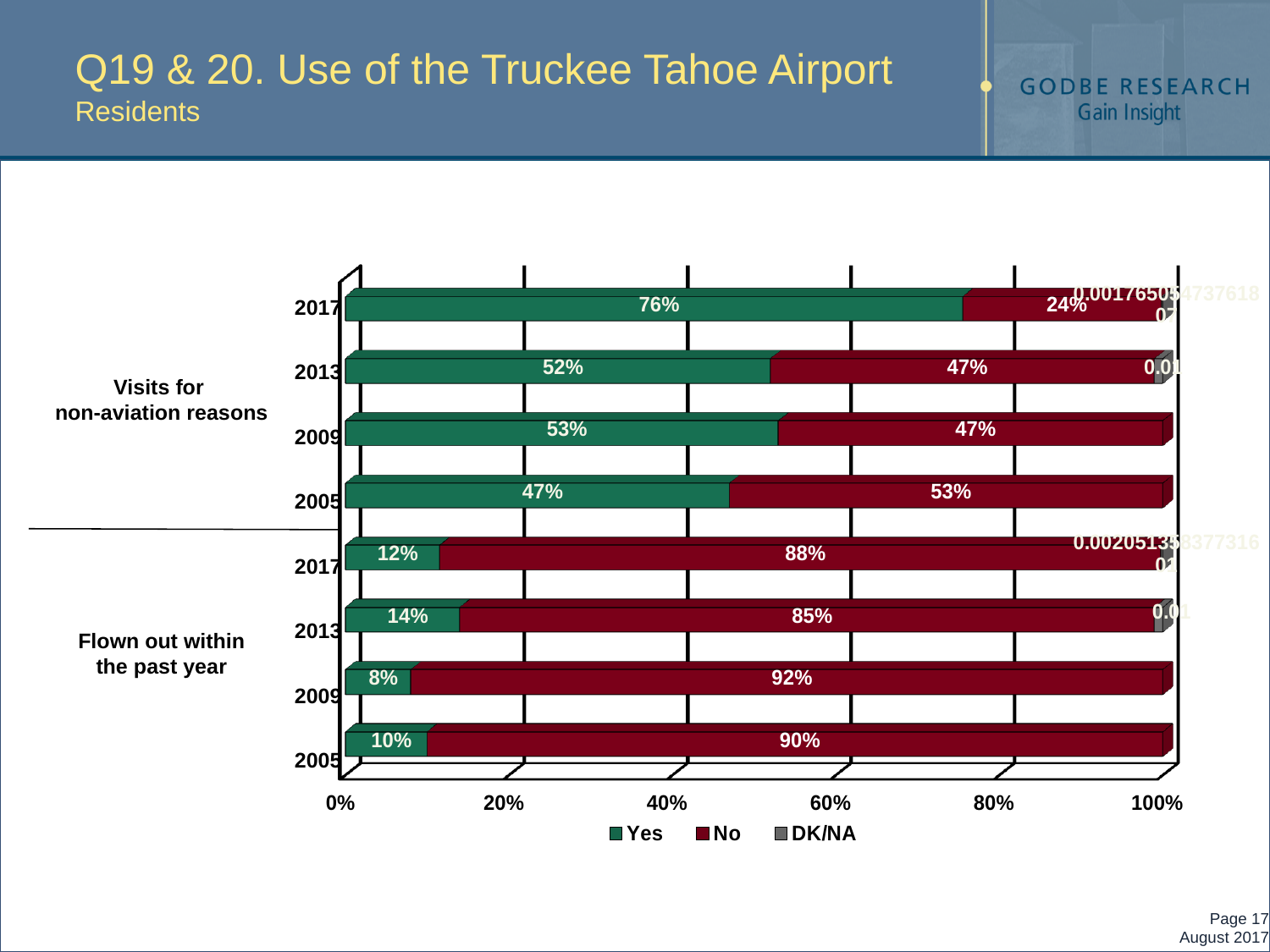
What percentage of residents said No to having flown out within the past year in 2009? 92% How many series does the legend list? 3 How many bars are shown in the chart? 8 Is the Yes value for visits for non-aviation reasons in 2017 greater or less than 60%? greater In which year was the Yes share for having flown out within the past year the lowest? 2009 What kind of chart is shown on the slide? Stacked bar chart Which is larger: the Yes share for flown out within the past year in 2017 or in 2005? 2017 What is the difference between the Yes share for visits for non-aviation reasons in 2017 and in 2013? 24 percentage points What percentage of residents said No to visits for non-aviation reasons in 2005? 53% What percentage of residents said Yes to visits for non-aviation reasons in 2017? 76% In which year was the Yes share for visits for non-aviation reasons the highest? 2017 What percentage of residents said Yes to having flown out within the past year in 2013? 14%